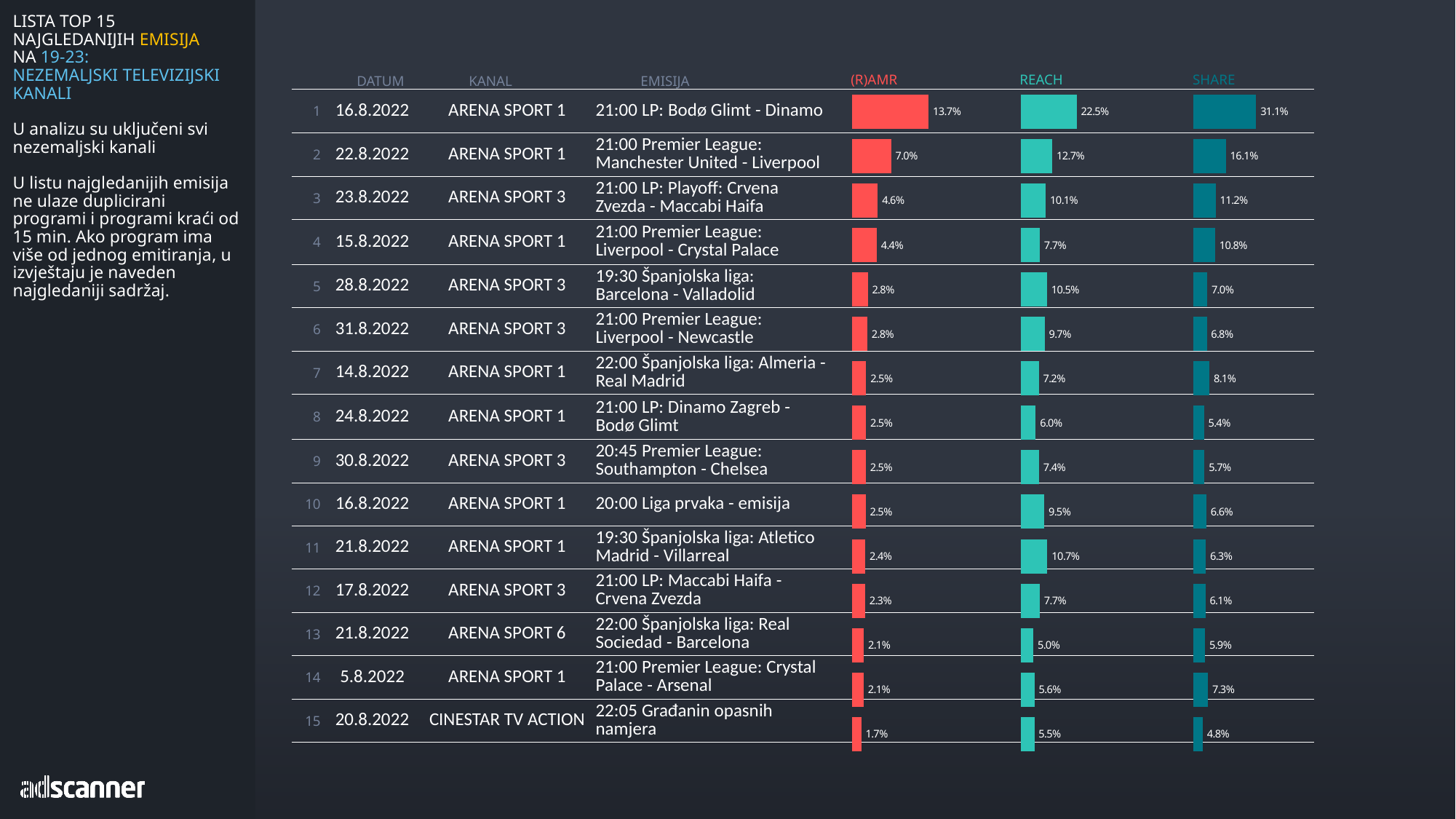
Which has the higher REACH value: 19:30 Španjolska liga: Barcelona - Valladolid or 21:00 Premier League: Liverpool - Crystal Palace? 19:30 Španjolska liga: Barcelona - Valladolid What kind of chart is used to display the (R)AMR, REACH and SHARE values? Bar chart What colour are the bars in the REACH column? Turquoise What is the difference in (R)AMR between 21:00 LP: Bodø Glimt - Dinamo and 21:00 Premier League: Manchester United - Liverpool? 6.7% What is the REACH value for 19:30 Španjolska liga: Atletico Madrid - Villarreal? 10.7% Which programme has the highest SHARE value? 21:00 LP: Bodø Glimt - Dinamo What is the (R)AMR value for the top-ranked programme, 21:00 LP: Bodø Glimt - Dinamo? 13.7% How many programmes are listed in the table? 15 What is the SHARE value for 21:00 LP: Playoff: Crvena Zvezda - Maccabi Haifa? 11.2% Which programme has the lowest (R)AMR value? 22:05 Građanin opasnih namjera What is the REACH value for 21:00 Premier League: Manchester United - Liverpool? 12.7% Do the (R)AMR values rise or fall going down the list from rank 1 to rank 15? Fall